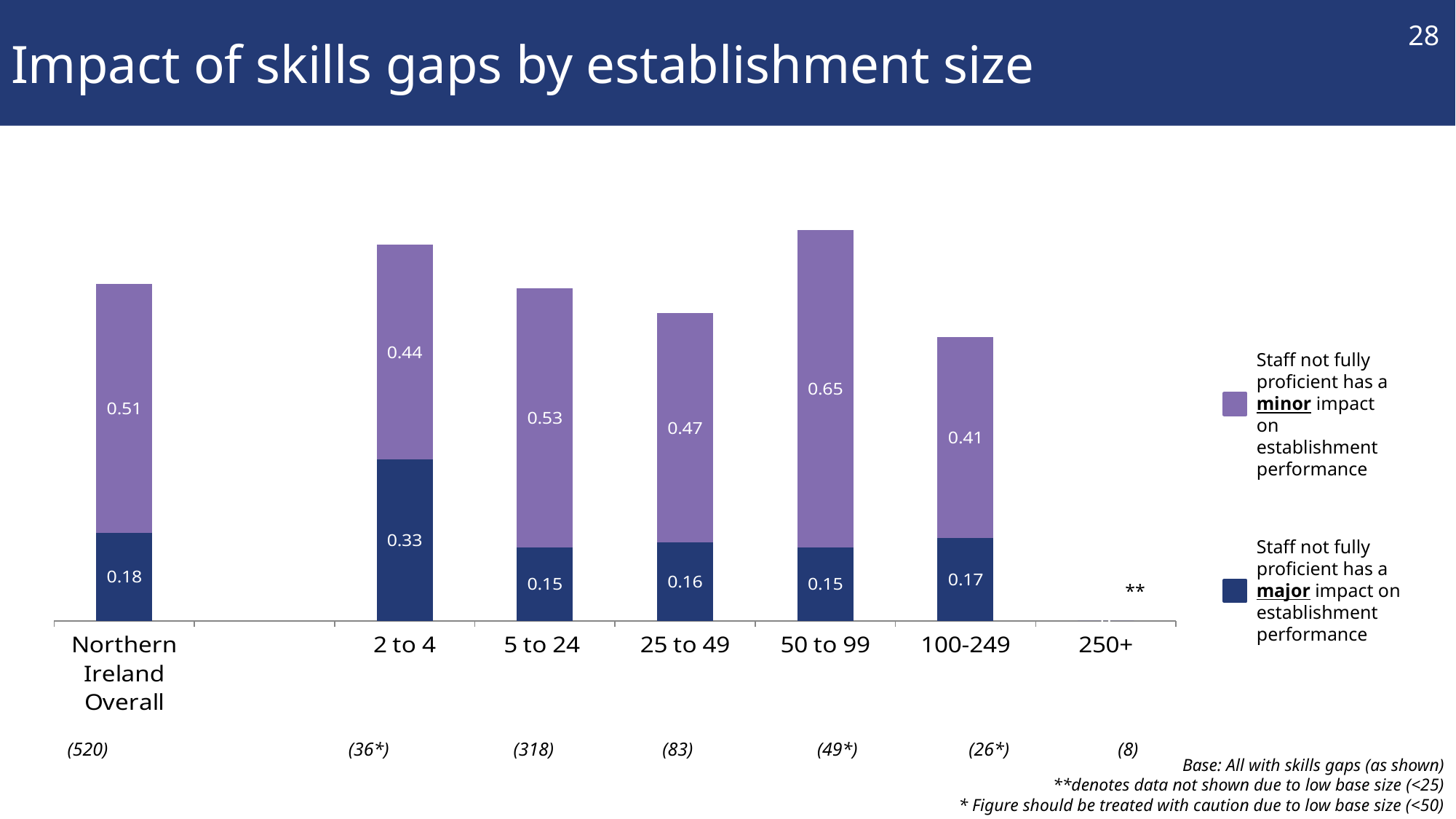
How many series does the legend list? 2 What kind of chart is shown on the slide? Stacked bar chart Which establishment size has the highest 'major impact' value? 2 to 4 Which establishment size category shows no data (marked with **)? 250+ What is the value for 'major impact' for the 2 to 4 establishment size? 0.33 Which is larger, the 'major impact' value for 25 to 49 or for 100-249? 100-249 What is the value for 'minor impact' for the 50 to 99 establishment size? 0.65 What is the total of the stacked bar for the 50 to 99 establishment size? 0.80 Which establishment size has the highest 'minor impact' value? 50 to 99 What is the difference between the 'minor impact' values for 5 to 24 and 100-249? 0.12 What is the total of the stacked bar for Northern Ireland Overall? 0.69 What is the 'minor impact' value for Northern Ireland Overall? 0.51